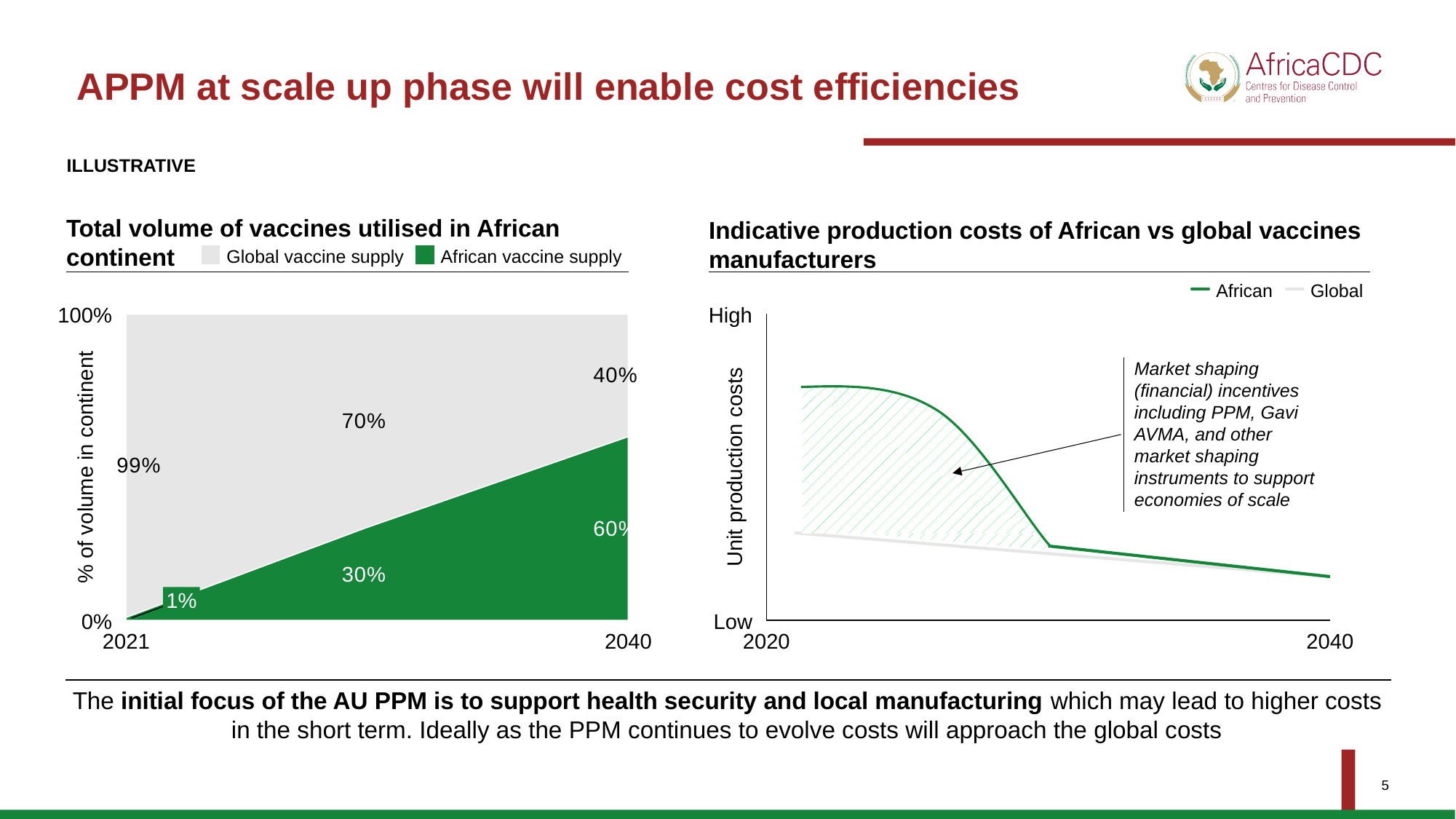
How many series does the legend of the 'Indicative production costs of African vs global vaccines manufacturers' chart list? 2 In the 'Total volume of vaccines utilised in African continent' chart, what is the total of the Global and African shares at 2040 (40% + 60%)? 100% In the 'Total volume of vaccines utilised in African continent' chart, does the African vaccine supply share rise or fall from 2021 to 2040? rise In the 'Total volume of vaccines utilised in African continent' chart, what share does African vaccine supply reach by 2040? 60% In the 'Total volume of vaccines utilised in African continent' chart, what is the difference between the Global vaccine supply share and the African vaccine supply share at the midpoint labels (70% and 30%)? 40% In the 'Total volume of vaccines utilised in African continent' chart, what share does Global vaccine supply have by 2040? 40% How many series does the legend of the 'Total volume of vaccines utilised in African continent' chart list? 2 In the 'Indicative production costs of African vs global vaccines manufacturers' chart, does the African unit production cost rise or fall from 2020 to 2040? fall In the 'Total volume of vaccines utilised in African continent' chart, which is larger in 2040: Global vaccine supply or African vaccine supply? African vaccine supply In the 'Total volume of vaccines utilised in African continent' chart, what share of volume does Global vaccine supply have at the start (2021)? 99% In the 'Indicative production costs of African vs global vaccines manufacturers' chart, what is the label on the vertical axis? Unit production costs In the 'Total volume of vaccines utilised in African continent' chart, what share of volume does African vaccine supply have at the start (2021)? 1%